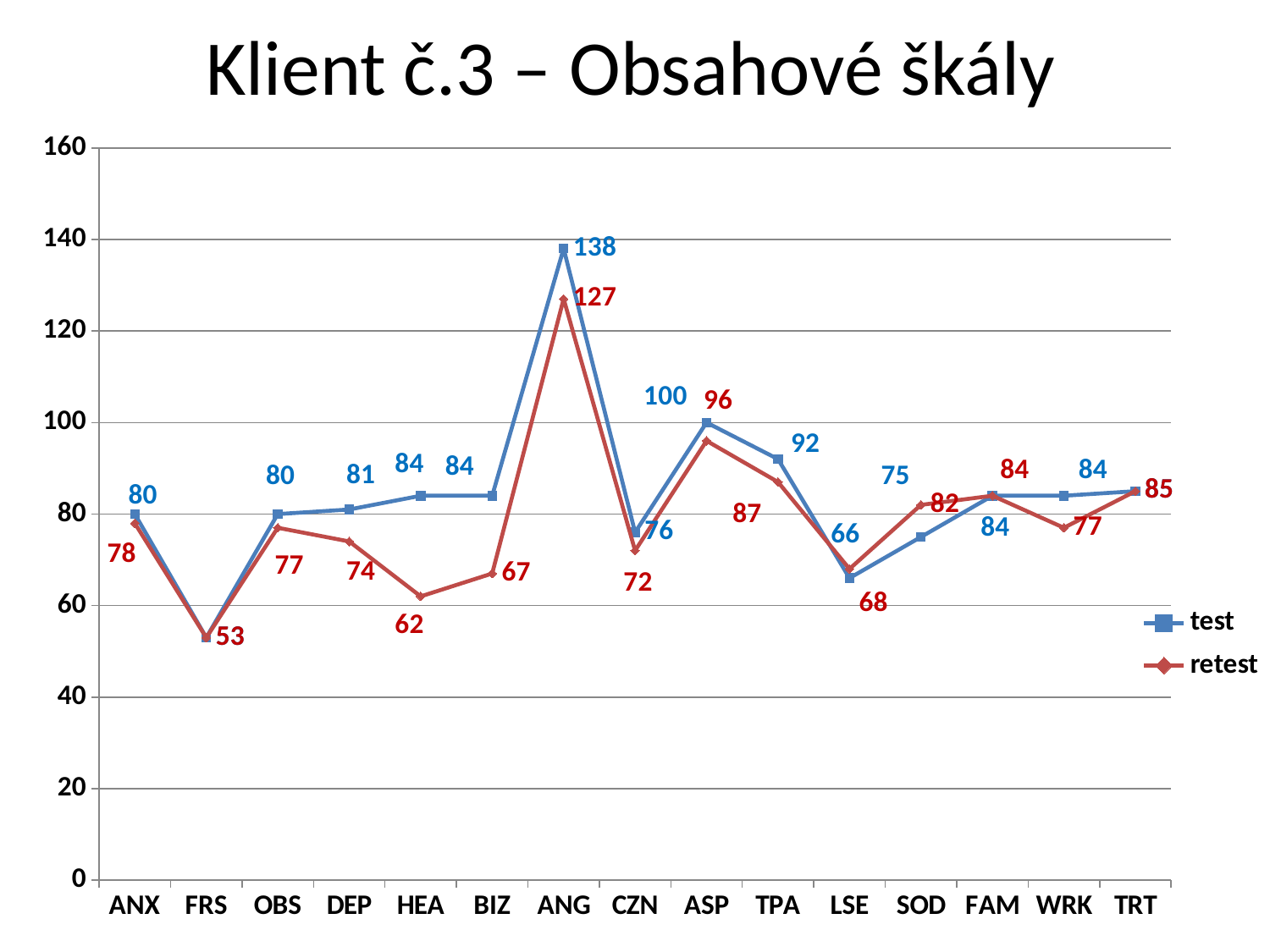
What is the retest value for HEA? 62 Is the retest value for BIZ greater or less than 80? less Which category has the lowest retest value? FRS What is the title of the chart? Klient č.3 – Obsahové škály How many categories are shown on the x axis? 15 What is the test value for ASP? 100 Which category has the highest test value? ANG What is the test value for ANG? 138 What is the difference between the test and retest values for ANG? 11 For SOD, which series has the larger value, test or retest? retest What kind of chart is shown on the slide? line chart How many series does the legend list? 2